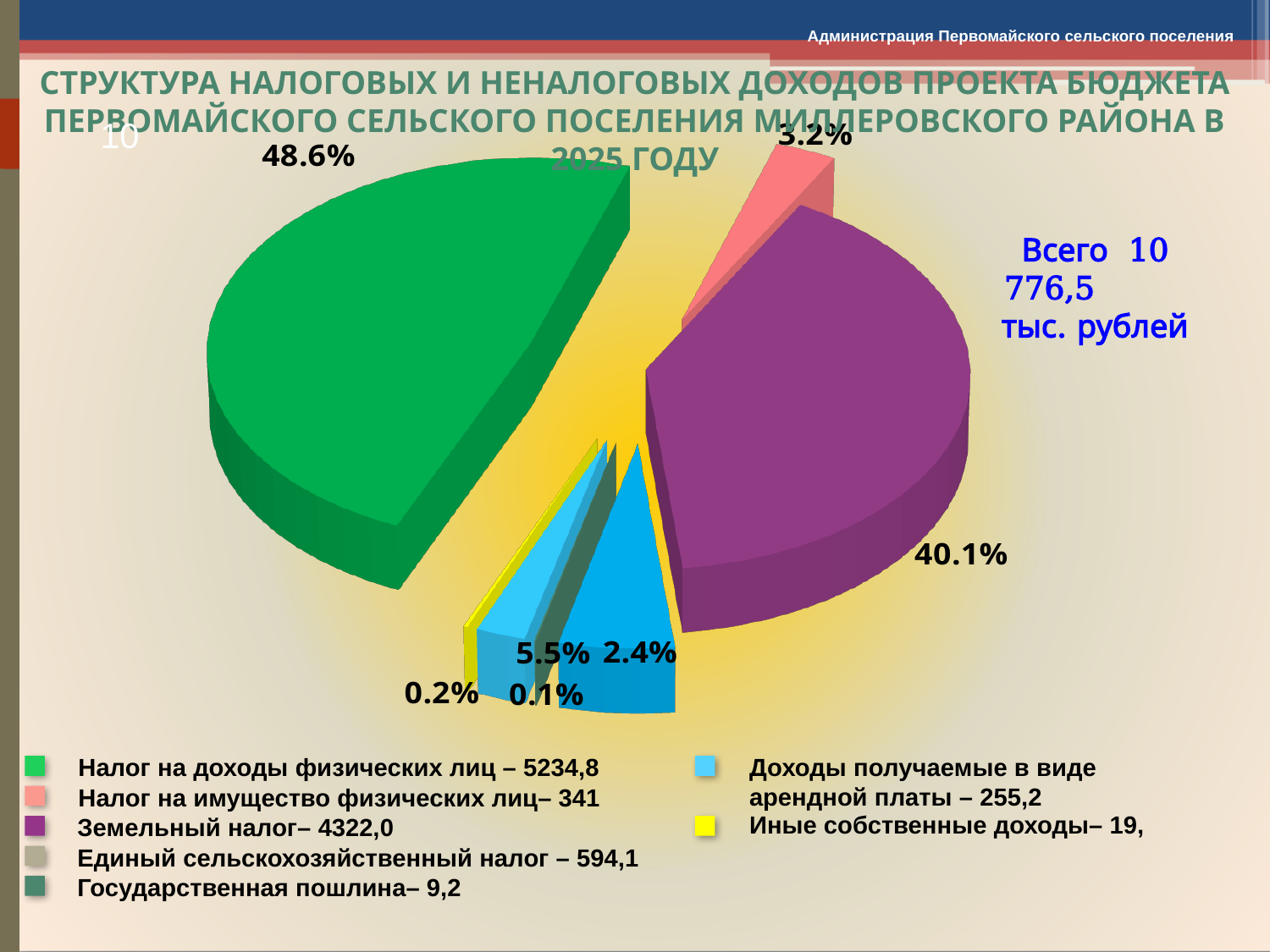
Which category has the smallest slice of the pie? Государственная пошлина How many slices does the pie chart have? 7 What kind of chart is shown on the slide? pie chart What share of the pie does Земельный налог represent? 40.1% What is the value shown in the legend for Земельный налог? 4322,0 What total amount is stated on the slide for all revenues? 10 776,5 тыс. рублей Which is larger, the share for Земельный налог or the share for Налог на имущество физических лиц? Земельный налог Which category has the largest slice of the pie? Налог на доходы физических лиц What share of the pie does Налог на имущество физических лиц represent? 3.2% What is the value shown in the legend for Доходы получаемые в виде арендной платы? 255,2 What share of the pie does Налог на доходы физических лиц represent? 48.6% What is the value shown in the legend for Единый сельскохозяйственный налог? 594,1